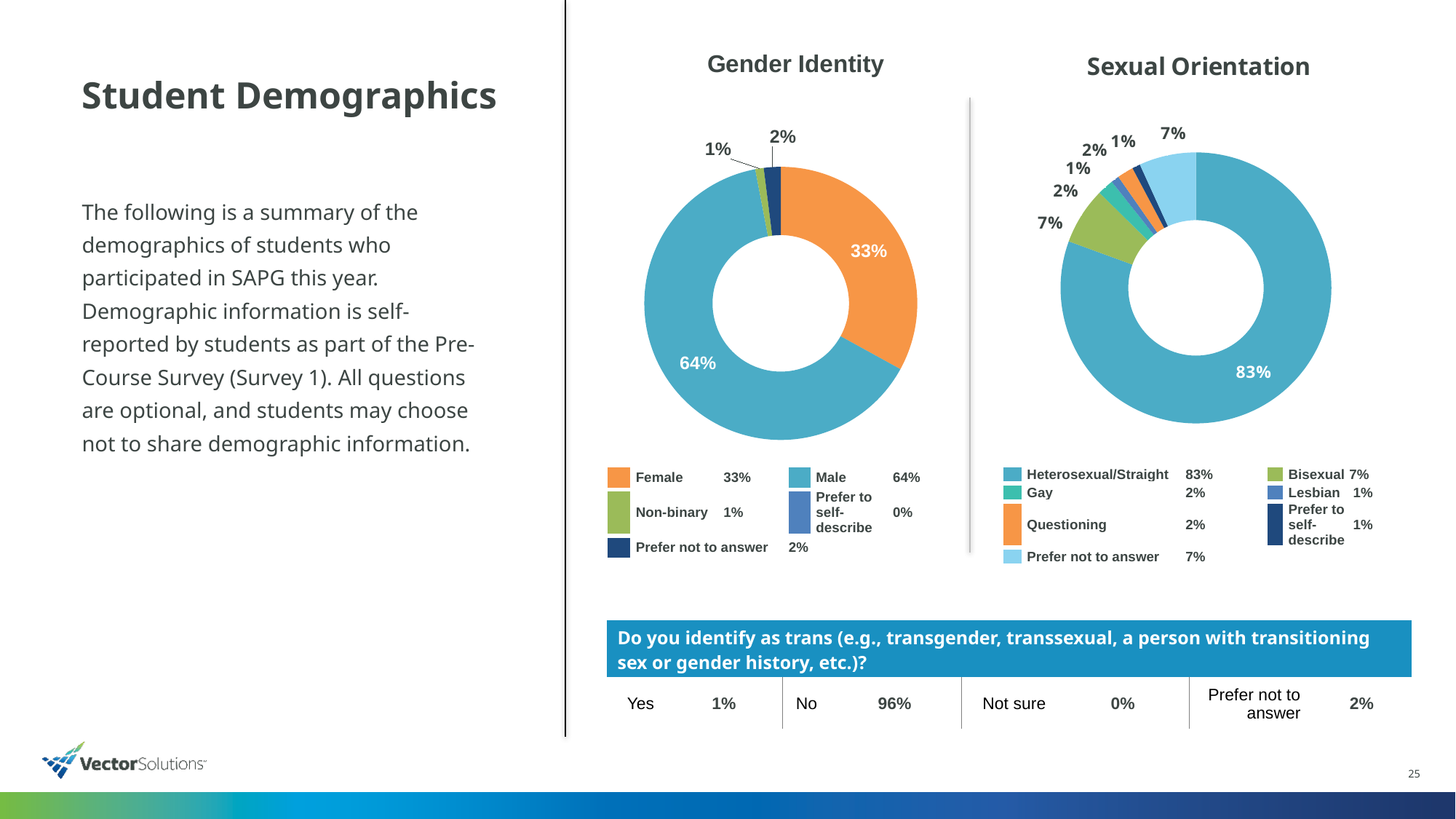
In the Gender Identity chart, what percentage of students identified as Male? 64% How many categories does the Sexual Orientation chart's legend list? 7 In the Sexual Orientation chart, what percentage of students identified as Bisexual? 7% In the Sexual Orientation chart, what percentage of students identified as Heterosexual/Straight? 83% In the Gender Identity chart, which category has the largest share? Male In the Gender Identity chart, what percentage of students chose Prefer not to answer? 2% In the Gender Identity chart, what percentage of students identified as Female? 33% How many categories does the Gender Identity chart's legend list? 5 In the Gender Identity chart, what is the difference between the Male and Female percentages? 31% In the Sexual Orientation chart, what percentage of students identified as Lesbian? 1% What type of chart is used for the Gender Identity data? Donut (pie) chart In the Sexual Orientation chart, which is larger: the share for Gay or the share for Prefer not to answer? Prefer not to answer